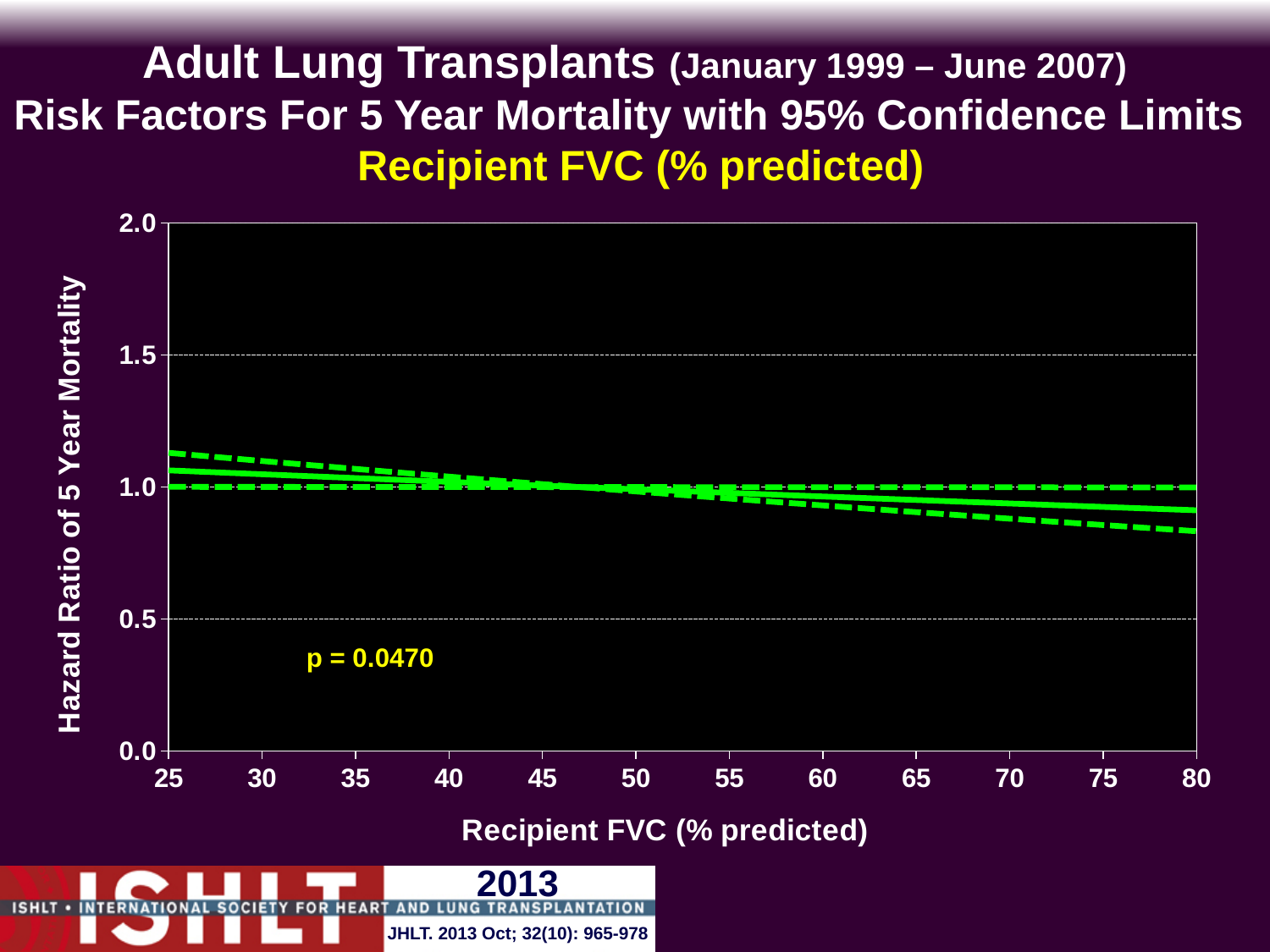
What p-value is printed on the chart? p = 0.0470 Is the lower confidence limit at a Recipient FVC of 80% predicted greater or less than 0.5? greater Is the hazard ratio at a Recipient FVC of 25% predicted greater or less than 1.0? greater Is the upper confidence limit at a Recipient FVC of 80% predicted greater or less than 1.5? less Is the hazard ratio higher at a Recipient FVC of 30% predicted or at 75% predicted? 30% predicted How many lines are plotted on the chart? 3 What is the label of the y axis? Hazard Ratio of 5 Year Mortality How many tick labels are shown on the x axis? 12 Does the hazard ratio rise or fall as Recipient FVC (% predicted) increases from 25 to 80? fall What kind of chart is shown on the slide? line chart